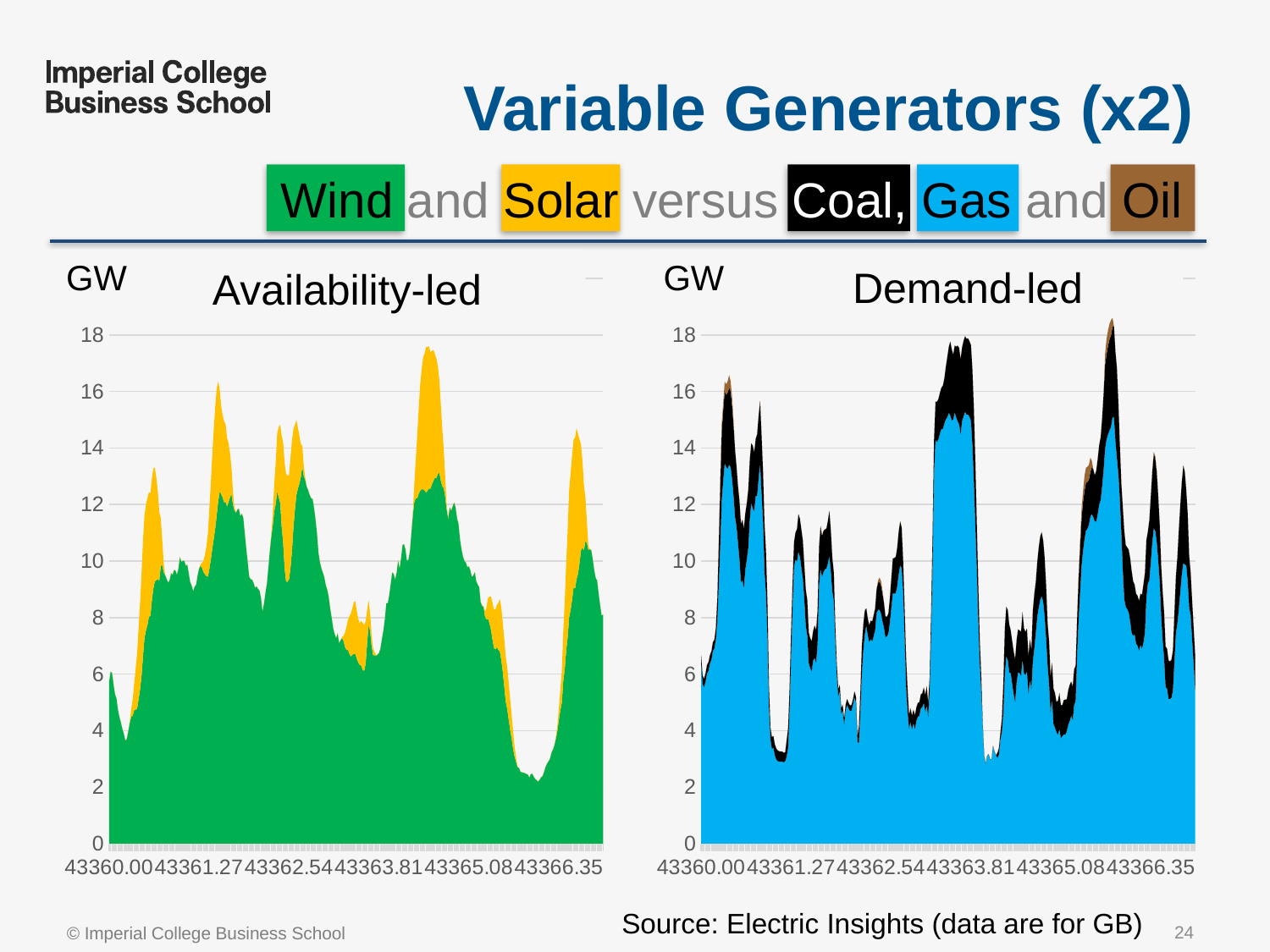
In the Demand-led chart, is the highest peak of the stacked area greater or less than 16 GW? greater What unit is shown on the y axis of both charts? GW What is the highest value labelled on the y axis of the Availability-led chart? 18 How many charts are shown on the slide? 2 In the Availability-led chart, is the highest peak of the stacked area greater or less than 16 GW? greater In the Demand-led chart, is the value at the right edge greater or less than 10 GW? less What is the first label shown on the x axis of the Demand-led chart? 43360.00 What type of chart is the Demand-led chart? Area chart What type of chart is the Availability-led chart? Area chart